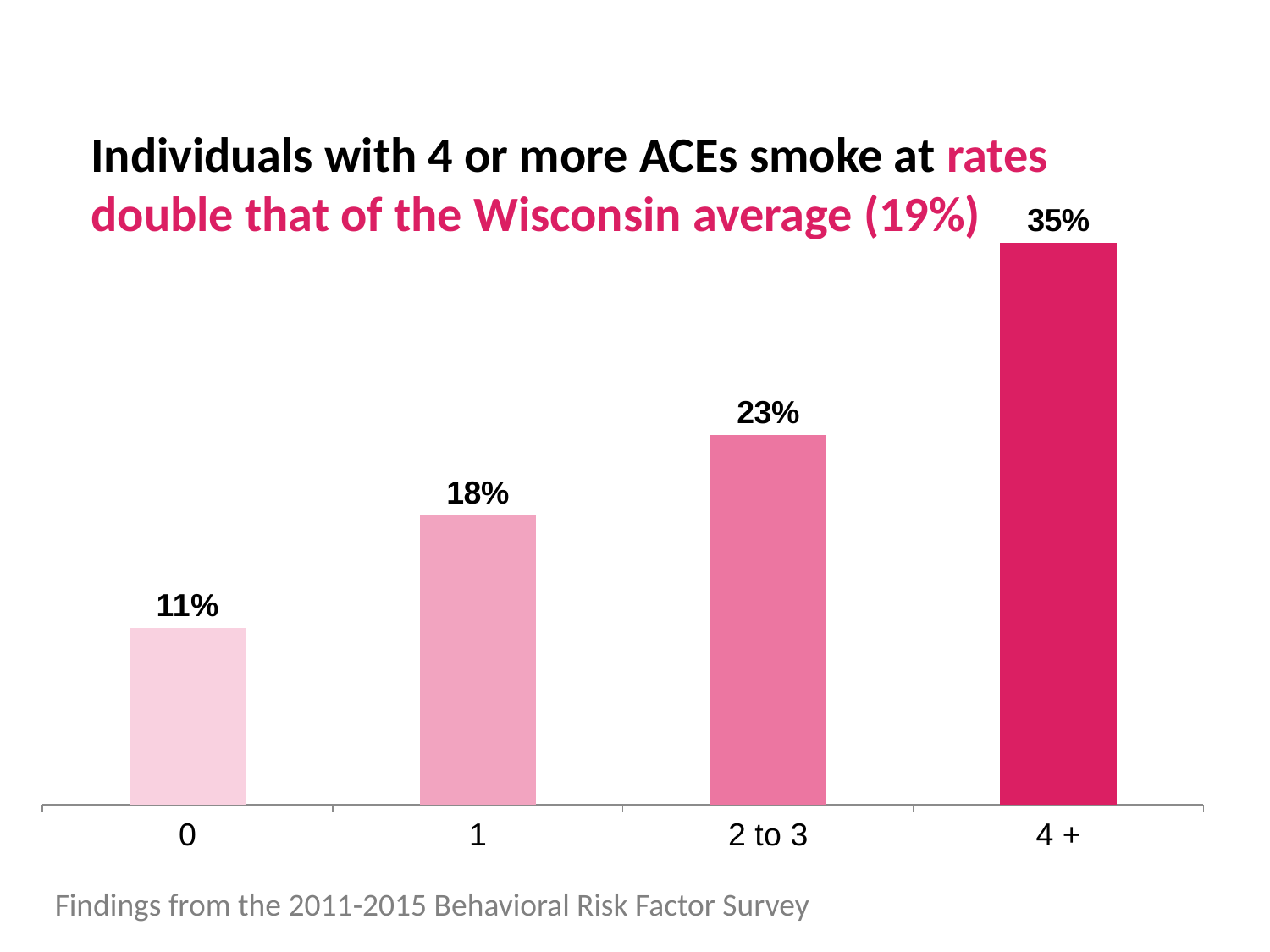
What is the smoking rate for individuals with 0 ACEs? 11% What is the smoking rate for individuals with 4 + ACEs? 35% What is the difference in smoking rate between the 4 + and 0 ACE categories? 24% What is the difference in smoking rate between the 2 to 3 and 1 ACE categories? 5% Which ACE category has the lowest smoking rate? 0 Which ACE category has the highest smoking rate? 4 + How many ACE categories are shown in the chart? 4 What is the smoking rate for individuals with 2 to 3 ACEs? 23% Which has a higher smoking rate, the 1 ACE category or the 2 to 3 ACE category? 2 to 3 What is the smoking rate for individuals with 1 ACE? 18% What kind of chart is shown on the slide? Bar chart Do the smoking rates rise or fall as the number of ACEs increases along the x axis? Rise